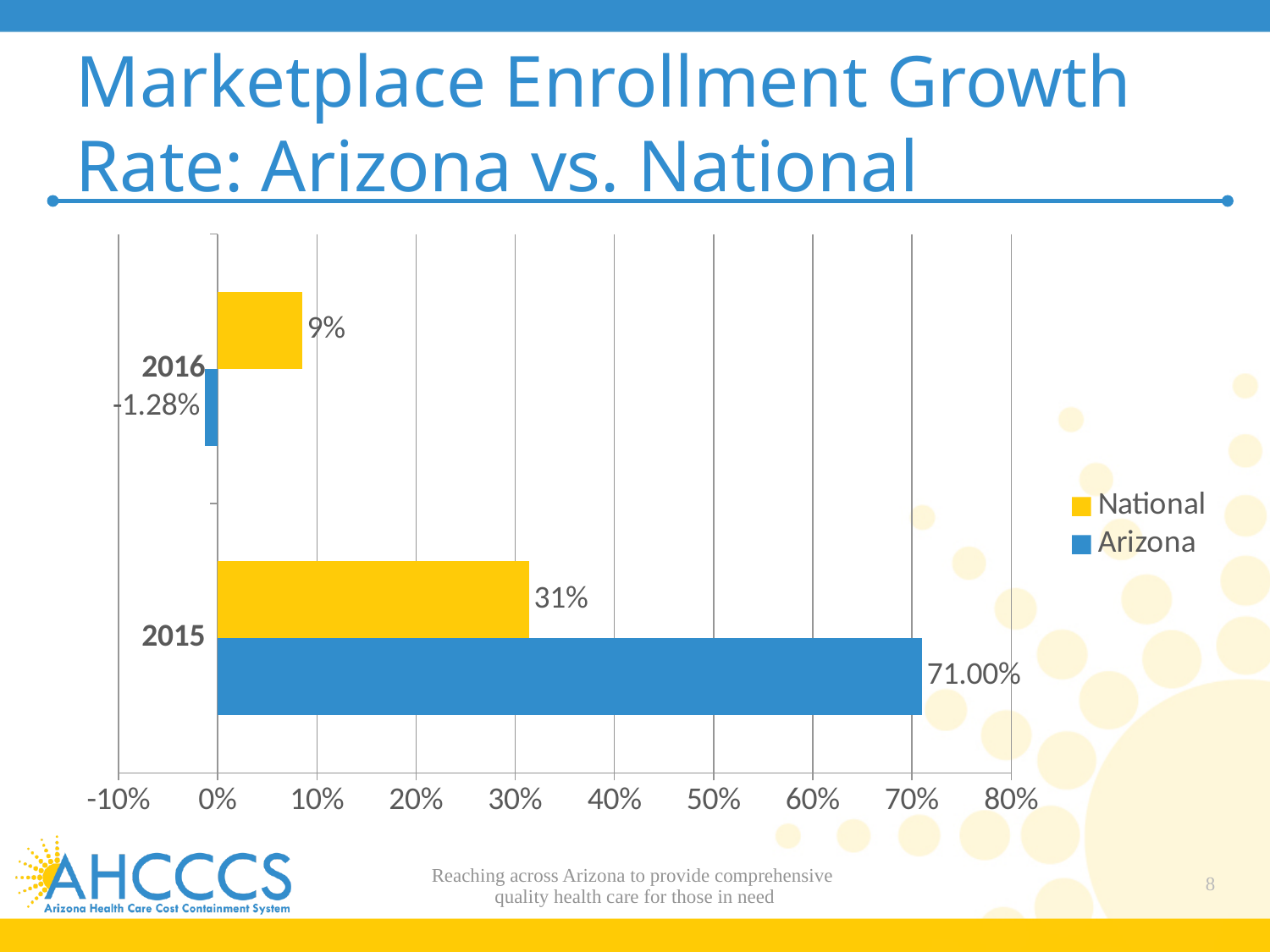
Which series has the highest value shown on the chart? Arizona (2015) What is the National marketplace enrollment growth rate for 2015? 31% Which bar shows the lowest value on the chart? Arizona (2016) What kind of chart is shown on the slide? Bar chart What is the Arizona marketplace enrollment growth rate for 2016? -1.28% Is the National growth rate for 2015 greater or less than 40%? less In 2016, which had the larger growth rate, Arizona or National? National What is the National marketplace enrollment growth rate for 2016? 9% What is the Arizona marketplace enrollment growth rate for 2015? 71.00% What colour represents Arizona in the chart? Blue In 2015, which had the larger growth rate, Arizona or National? Arizona How many series does the legend list? 2